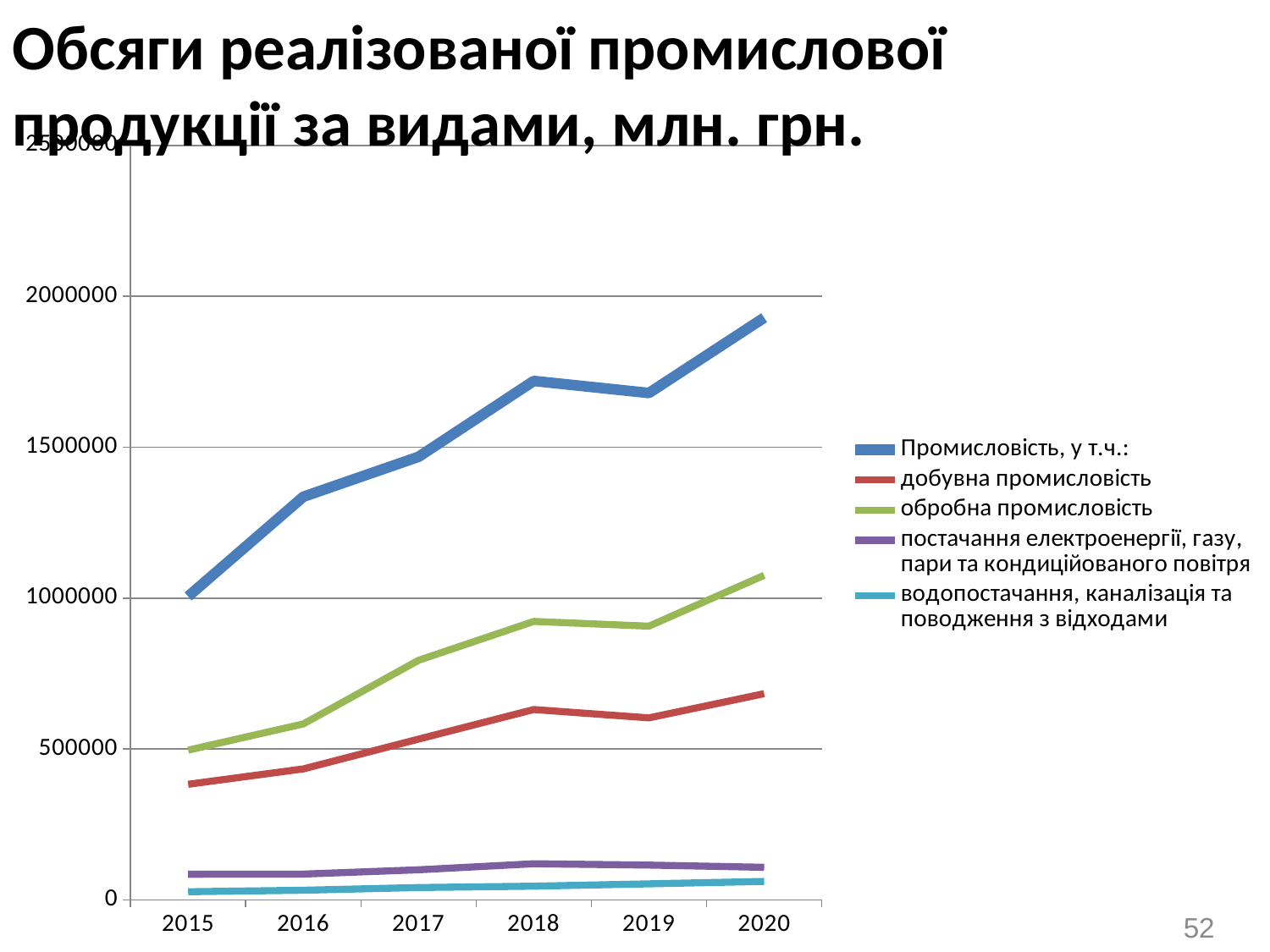
How many series does the legend list? 5 How many years are plotted along the x axis? 6 Is the value for добувна промисловість in 2015 greater or less than 500000? less In which year is the value for Промисловість, у т.ч.: highest? 2020 What is the title of the slide? Обсяги реалізованої промислової продукції за видами, млн. грн. In which year is the value for Промисловість, у т.ч.: lowest? 2015 Which series has the lowest values across all years? водопостачання, каналізація та поводження з відходами Does the value for обробна промисловість generally rise or fall from 2015 to 2020? rise Is the value for Промисловість, у т.ч.: in 2020 greater or less than 1500000? greater In 2020, which is larger: обробна промисловість or добувна промисловість? обробна промисловість Is the value for обробна промисловість in 2018 greater or less than 1000000? less What kind of chart is shown on the slide? line chart